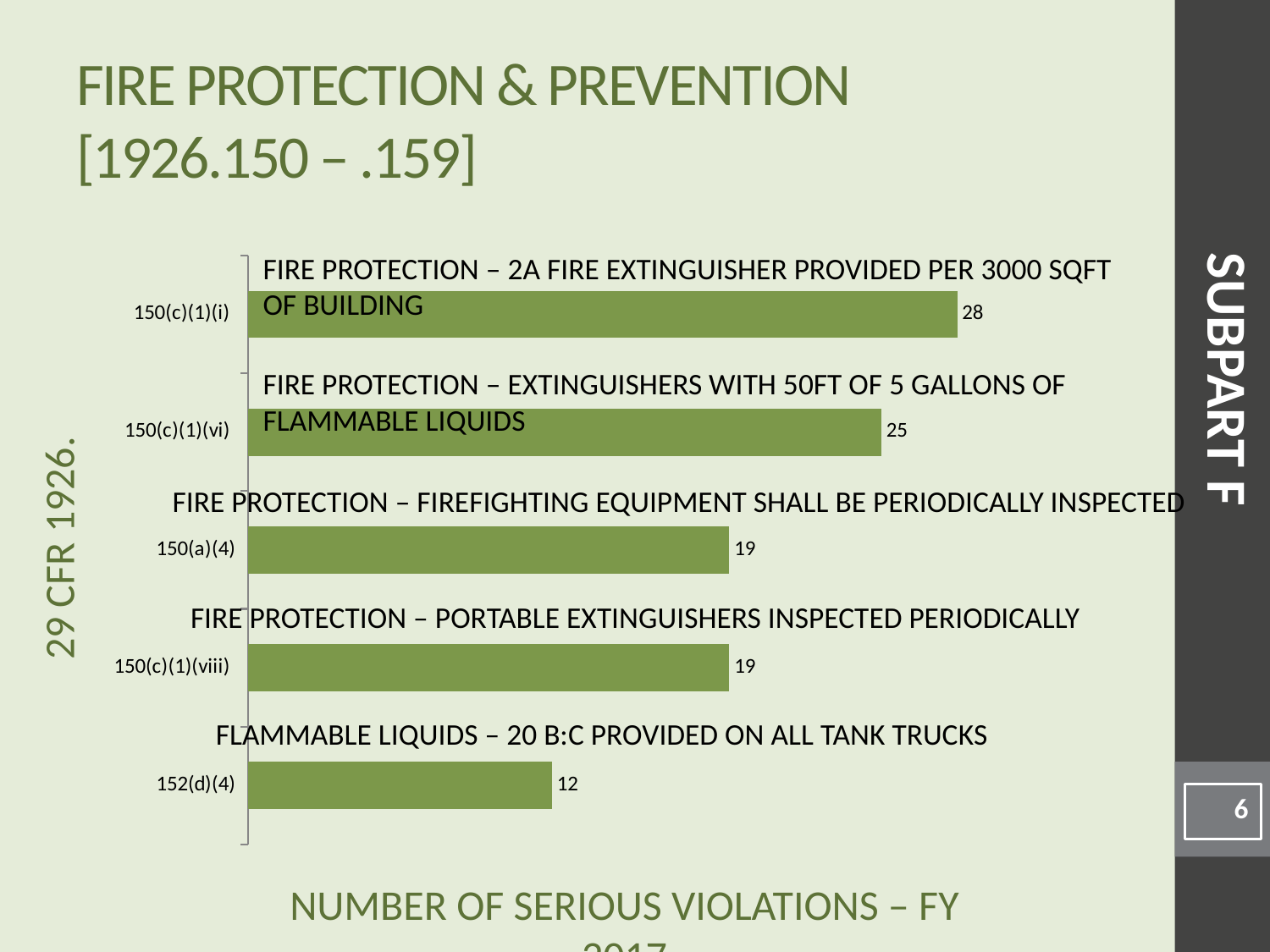
What is the difference between the values for 150(c)(1)(i) and 150(c)(1)(vi)? 3 What is the difference between the values for 150(c)(1)(vi) and 152(d)(4)? 13 Which category has the lowest number of serious violations? 152(d)(4) What is the title of the chart? NUMBER OF SERIOUS VIOLATIONS – FY 2017 What is the number of serious violations for 150(a)(4)? 19 What kind of chart is shown on the slide? Bar chart Which has more serious violations, 150(a)(4) or 152(d)(4)? 150(a)(4) What is the number of serious violations for 150(c)(1)(i)? 28 Which category has the highest number of serious violations? 150(c)(1)(i) What is the number of serious violations for 150(c)(1)(vi)? 25 How many categories are shown in the chart? 5 What is the number of serious violations for 152(d)(4)? 12